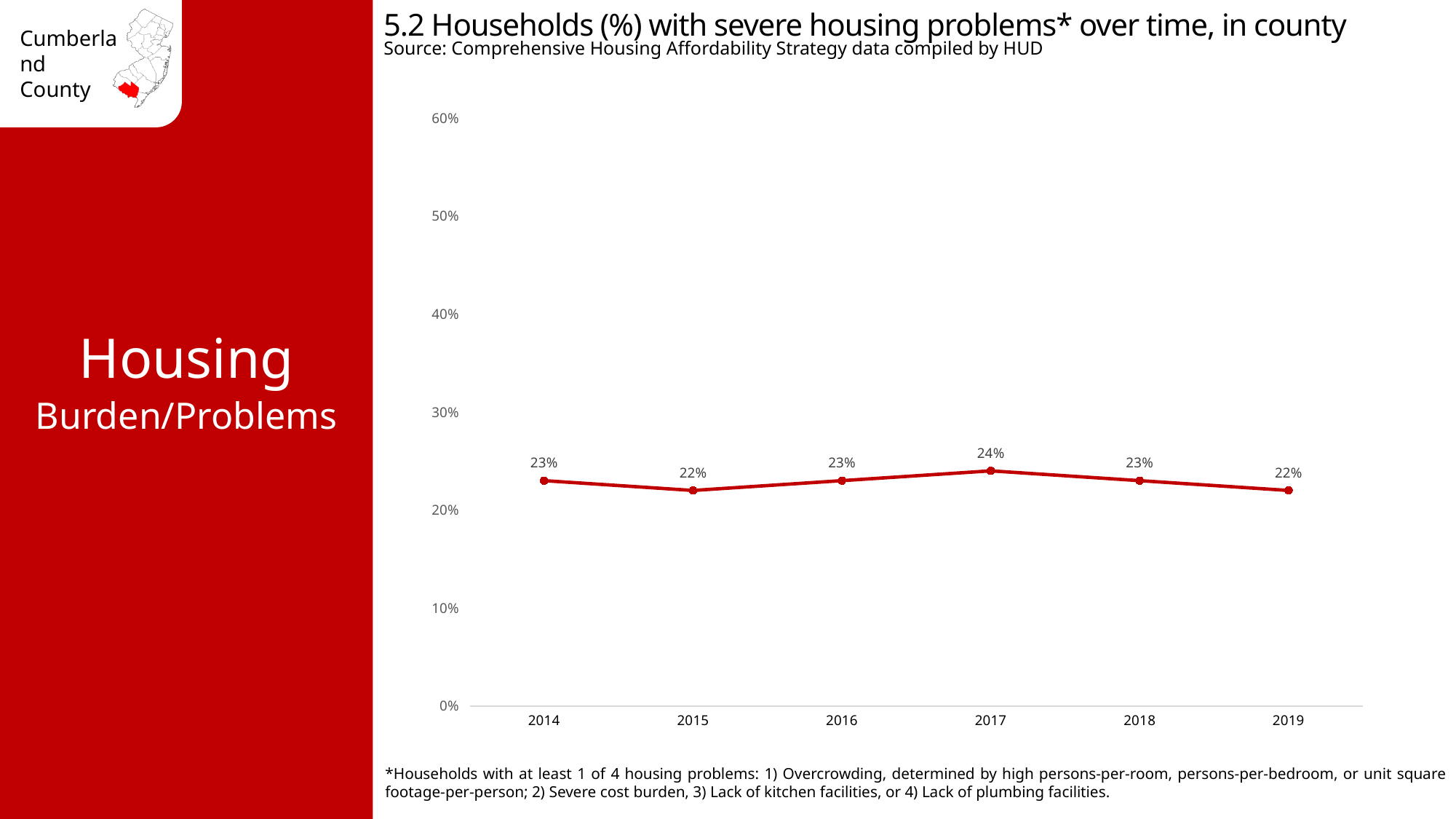
What percentage of households had severe housing problems in 2015? 22% What percentage of households had severe housing problems in 2017? 24% Is the value for 2017 greater or less than 30%? less What kind of chart is shown on the slide? line chart What percentage of households had severe housing problems in 2019? 22% What percentage of households had severe housing problems in 2014? 23% How many years are plotted on the chart? 6 Which year had the highest percentage of households with severe housing problems? 2017 Is the value for 2016 greater or less than 20%? greater What is the difference in percentage points between 2017 and 2019? 2 Did the percentage of households with severe housing problems rise or fall from 2017 to 2019? fall What is the source of the data shown in the chart? Comprehensive Housing Affordability Strategy data compiled by HUD